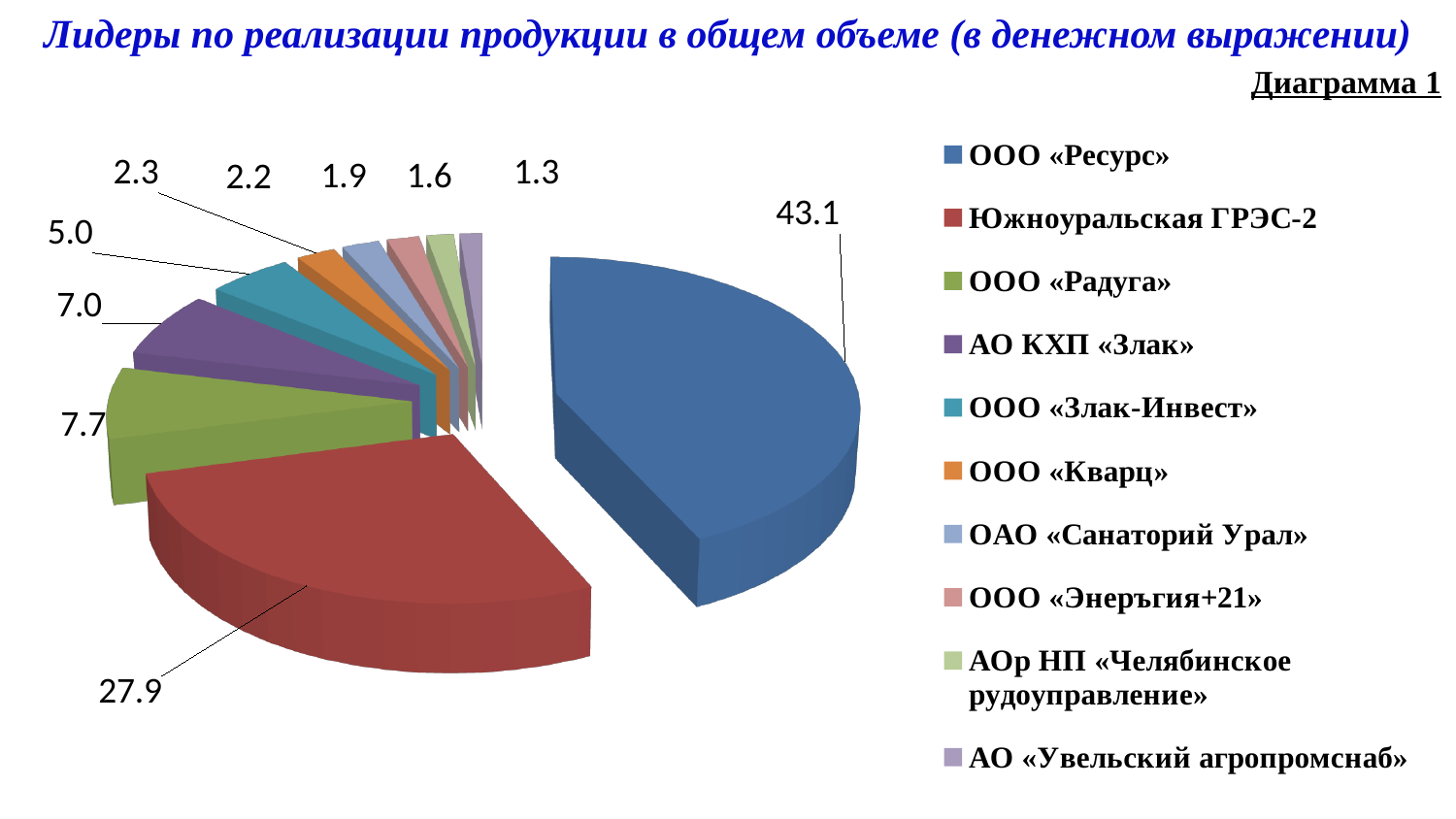
What is the difference between the values for ООО «Ресурс» and Южноуральская ГРЭС-2? 15.2 What colour is the slice for Южноуральская ГРЭС-2? red How many companies are listed in the legend? 10 What is the value for Южноуральская ГРЭС-2? 27.9 What kind of chart is shown on the slide? pie chart What is the value for АО КХП «Злак»? 7.0 Which company has the largest slice of the pie? ООО «Ресурс» What is the value for ООО «Радуга»? 7.7 What is the value for ООО «Ресурс»? 43.1 Which company has the smallest slice of the pie? АО «Увельский агропромснаб» What is the value for ООО «Злак-Инвест»? 5.0 Which is larger, the value for ООО «Радуга» or the value for АО КХП «Злак»? ООО «Радуга»